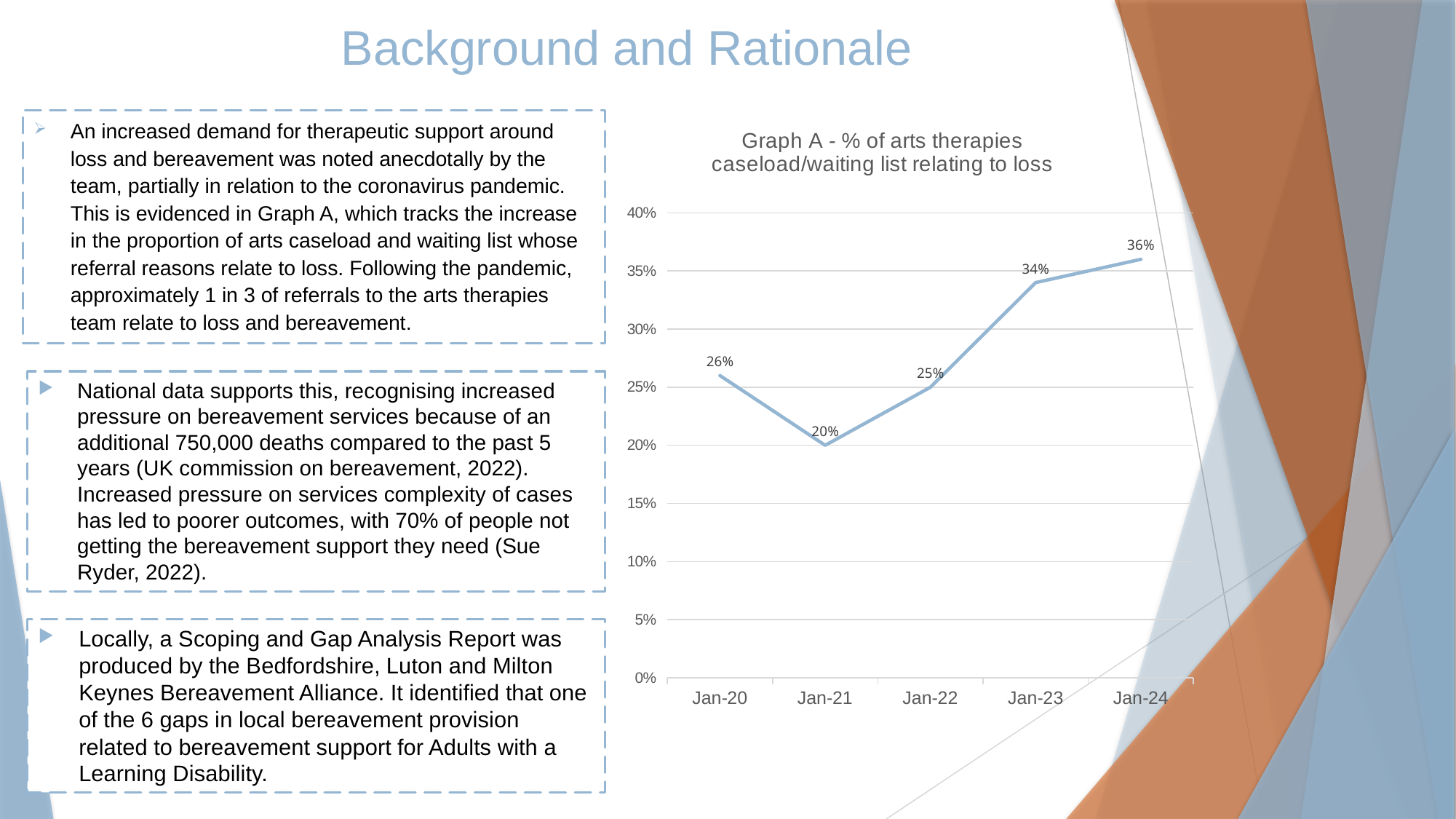
Which point has the highest value? Jan-24 What is the value for Jan-20? 26% What is the value for Jan-23? 34% What is the difference between the values for Jan-23 and Jan-22? 9% Which is larger, the value for Jan-20 or the value for Jan-22? Jan-20 What is the value for Jan-24? 36% What kind of chart is shown? Line chart What is the difference between the values for Jan-24 and Jan-20? 10% What is the title of the chart? Graph A - % of arts therapies caseload/waiting list relating to loss What is the value for Jan-21? 20% How many data points are plotted on the chart? 5 Which point has the lowest value? Jan-21